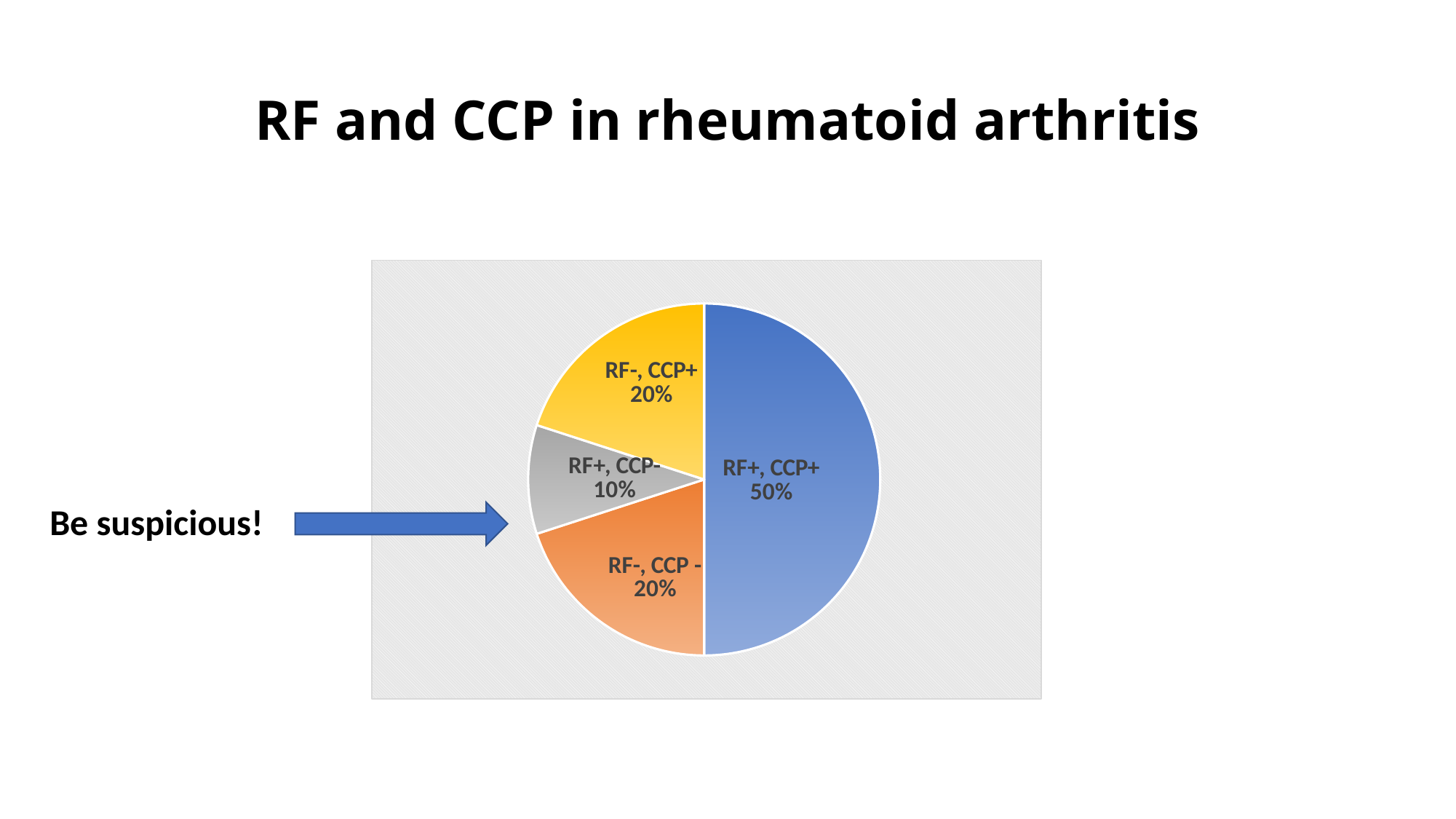
What is the value shown for the RF-, CCP- slice? 20% What is the value shown for the RF+, CCP- slice? 10% What is the difference between the RF+, CCP+ slice and the RF-, CCP+ slice? 30% What type of chart is shown on the slide? pie chart Which is larger, the RF-, CCP+ slice or the RF+, CCP- slice? RF-, CCP+ What share of the pie does the RF+, CCP+ slice represent? 50% What is the value shown for the RF-, CCP+ slice? 20% What is the title of the slide containing the pie chart? RF and CCP in rheumatoid arthritis Which slice does the arrow labelled 'Be suspicious!' point to? RF+, CCP- How many slices does the pie chart have? 4 Which slice of the pie is the largest? RF+, CCP+ Which slice of the pie is the smallest? RF+, CCP-